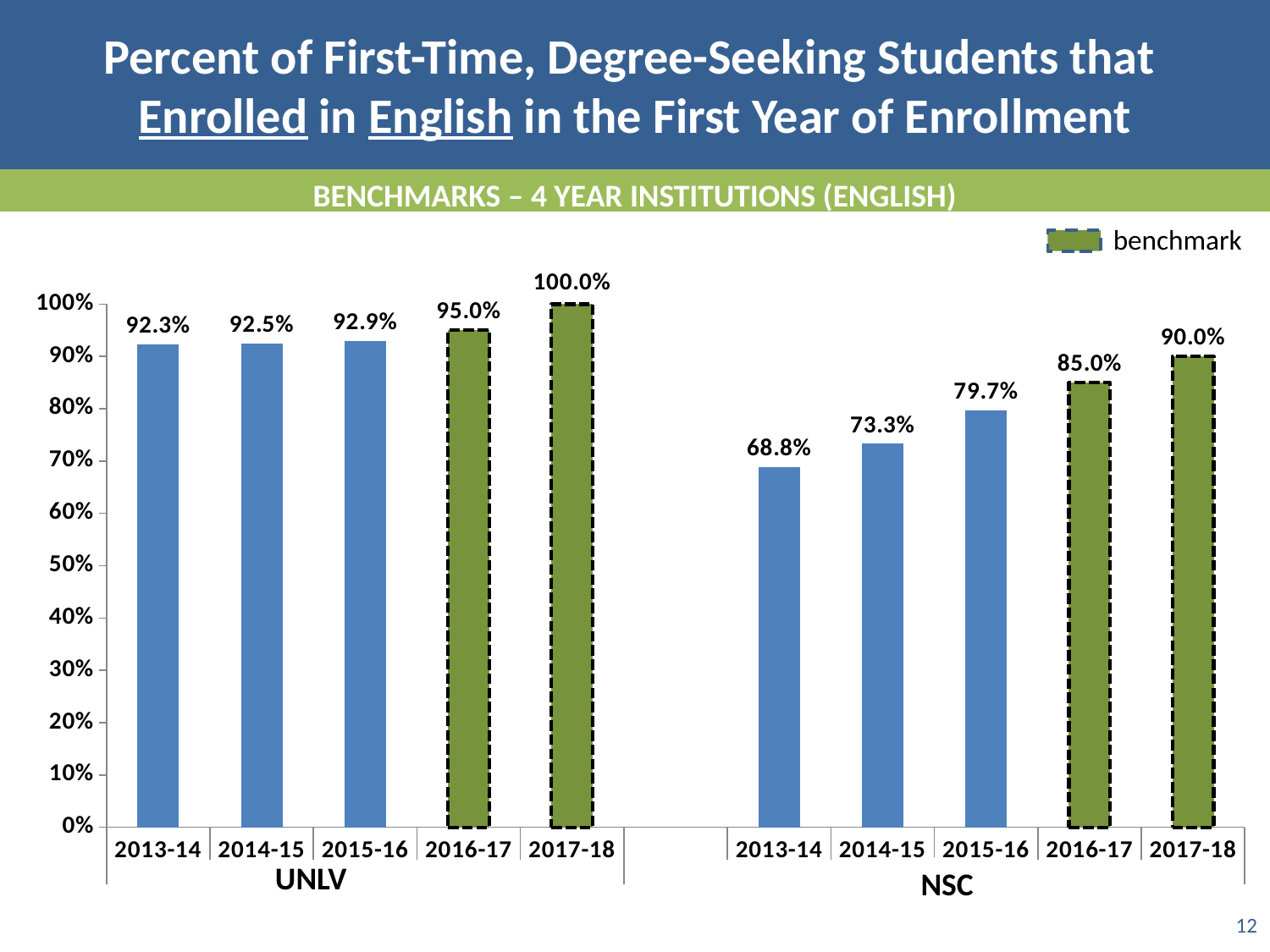
What is the value for NSC in 2015-16? 79.7% What is the 2016-17 benchmark value for UNLV? 95.0% What kind of chart is shown on the slide? bar chart Do the NSC values rise or fall from 2013-14 to 2017-18? rise Which is larger, the UNLV value for 2015-16 or the NSC value for 2015-16? UNLV 2015-16 How many bars are plotted for NSC? 5 Which year has the lowest value for NSC? 2013-14 What is the 2017-18 benchmark value for NSC? 90.0% Which year has the highest value for NSC? 2017-18 What is the difference between the NSC values for 2015-16 and 2013-14? 10.9% Is the value for NSC in 2014-15 greater or less than 70%? greater What is the value for UNLV in 2013-14? 92.3%